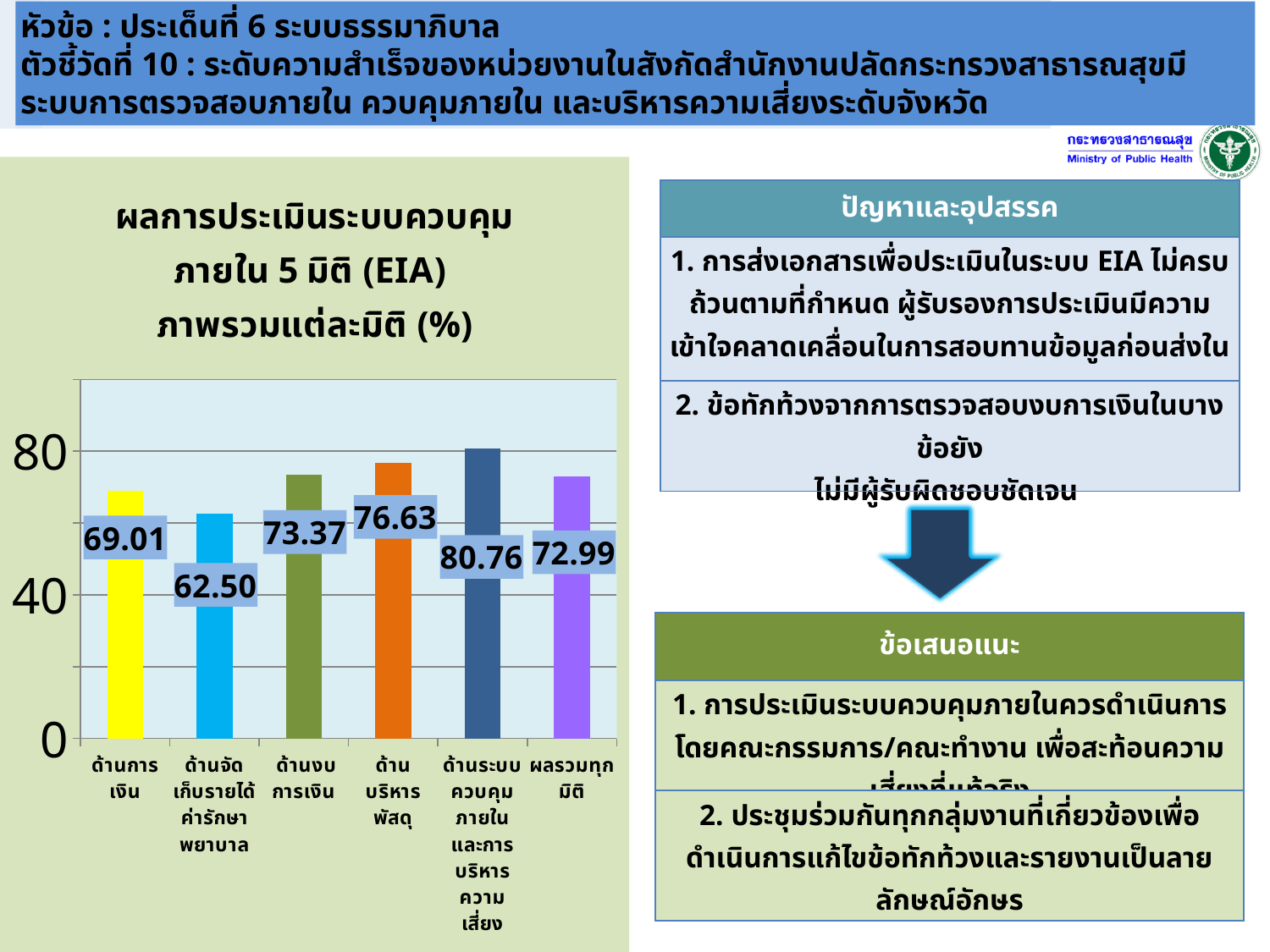
What is the value for ด้านการเงิน? 69.01 What is the value for ด้านบริหารพัสดุ? 76.63 Which is larger, the value for ด้านงบการเงิน or the value for ด้านการเงิน? ด้านงบการเงิน Which category has the highest value? ด้านระบบควบคุมภายในและการบริหารความเสี่ยง What is the title of the chart? ผลการประเมินระบบควบคุมภายใน 5 มิติ (EIA) ภาพรวมแต่ละมิติ (%) What is the value for ผลรวมทุกมิติ? 72.99 What is the difference between the values for ด้านระบบควบคุมภายในและการบริหารความเสี่ยง and ด้านจัดเก็บรายได้ค่ารักษาพยาบาล? 18.26 How many categories are shown in the chart? 6 What kind of chart is shown on the slide? bar chart Which category has the lowest value? ด้านจัดเก็บรายได้ค่ารักษาพยาบาล What is the value for ด้านจัดเก็บรายได้ค่ารักษาพยาบาล? 62.50 Is the value for ด้านระบบควบคุมภายในและการบริหารความเสี่ยง greater or less than 80? greater